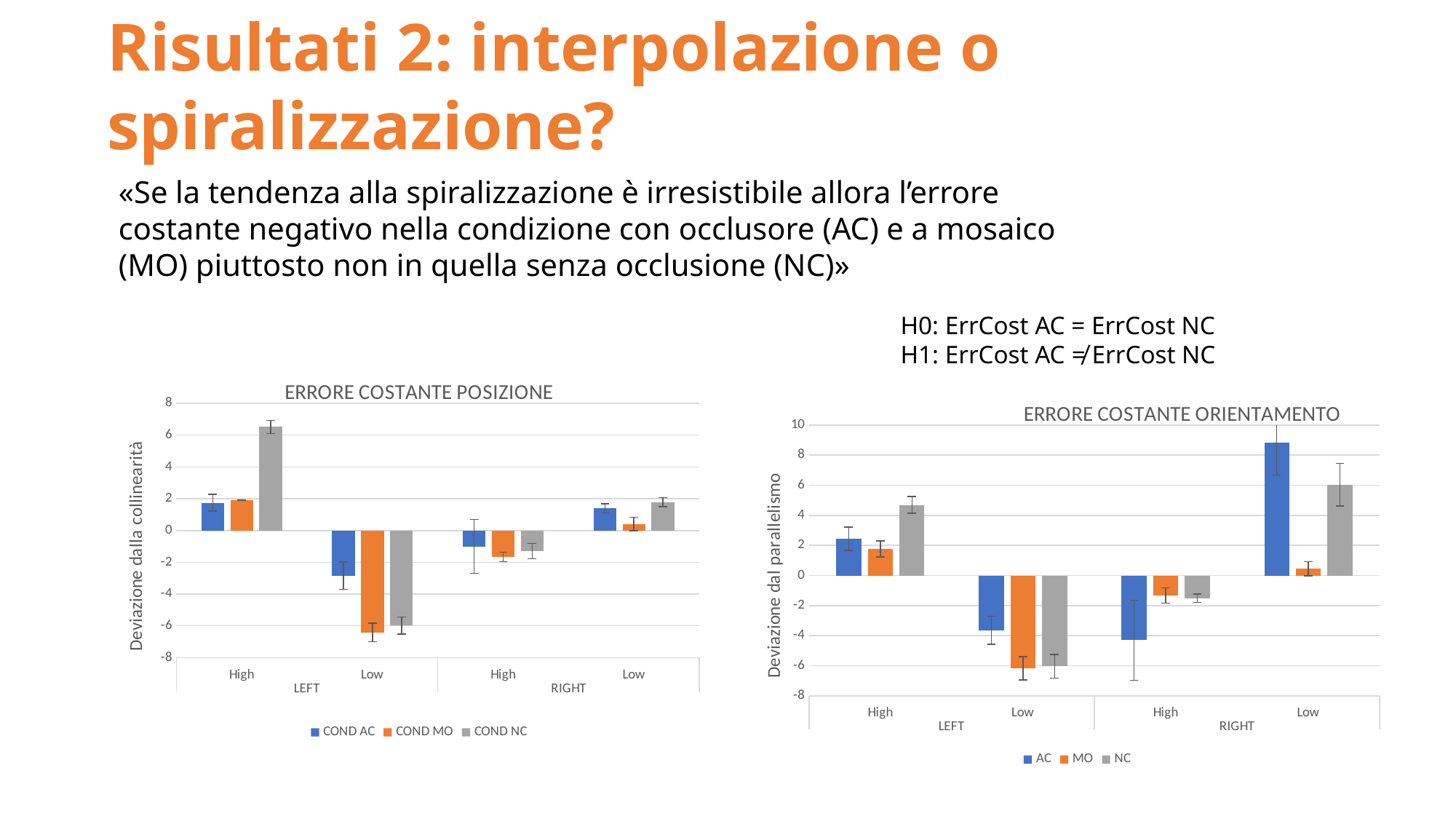
In the "ERRORE COSTANTE POSIZIONE" chart, which series has the lowest bar in the LEFT Low group? COND MO In the "ERRORE COSTANTE ORIENTAMENTO" chart, in the LEFT High group, which is larger: NC or AC? NC In the "ERRORE COSTANTE POSIZIONE" chart, which series has the highest bar in the LEFT High group? COND NC In the "ERRORE COSTANTE POSIZIONE" chart, is the value for COND NC in the LEFT High group greater or less than 4? greater In the "ERRORE COSTANTE POSIZIONE" chart, how many series does the legend list? 3 In the "ERRORE COSTANTE ORIENTAMENTO" chart, which series has the highest bar in the RIGHT Low group? AC In the "ERRORE COSTANTE POSIZIONE" chart, in the LEFT High group, which is larger: COND NC or COND AC? COND NC What is the y-axis title of the "ERRORE COSTANTE ORIENTAMENTO" chart? Deviazione dal parallelismo In the "ERRORE COSTANTE POSIZIONE" chart, how many category groups (High/Low combinations) are shown on the x axis? 4 In the "ERRORE COSTANTE ORIENTAMENTO" chart, is the value for AC in the RIGHT Low group greater or less than 8? greater What kind of chart is the "ERRORE COSTANTE POSIZIONE" chart on the left? bar chart In the "ERRORE COSTANTE ORIENTAMENTO" chart, what are the legend entries? AC, MO, NC